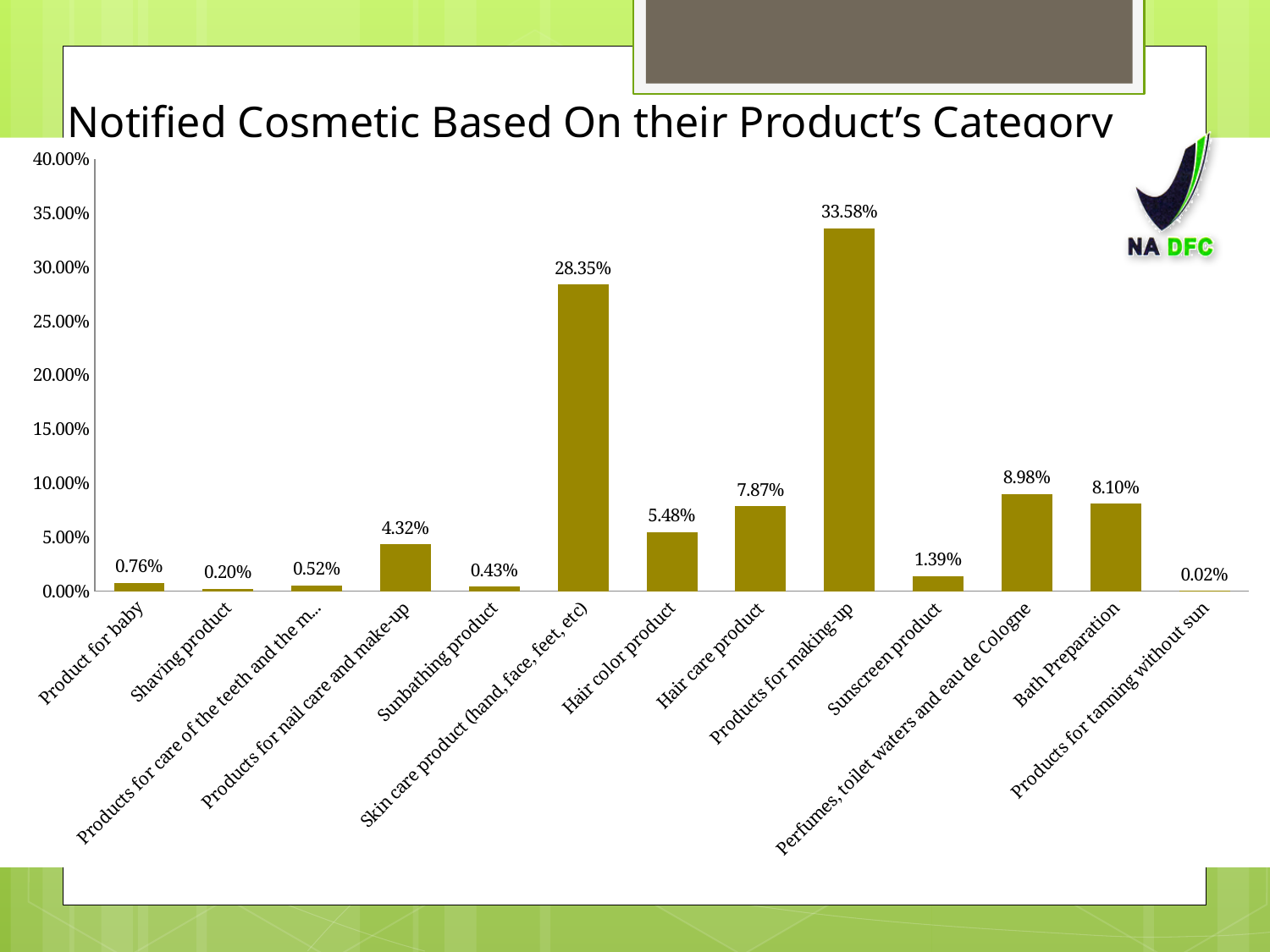
What is the value for Skin care product (hand, face, feet, etc)? 28.35% What is the title of the chart? Notified Cosmetic Based On their Product's Category What is the value for Sunscreen product? 1.39% What is the value for Perfumes, toilet waters and eau de Cologne? 8.98% Which category has the lowest value? Products for tanning without sun Is the value for Products for nail care and make-up greater or less than 5.00%? less What is the difference between the values for Products for making-up and Skin care product (hand, face, feet, etc)? 5.23% What is the value for Products for making-up? 33.58% How many categories are shown on the x axis? 13 Which is larger, the value for Hair care product or the value for Bath Preparation? Bath Preparation Which category has the highest value? Products for making-up What kind of chart is shown on the slide? bar chart